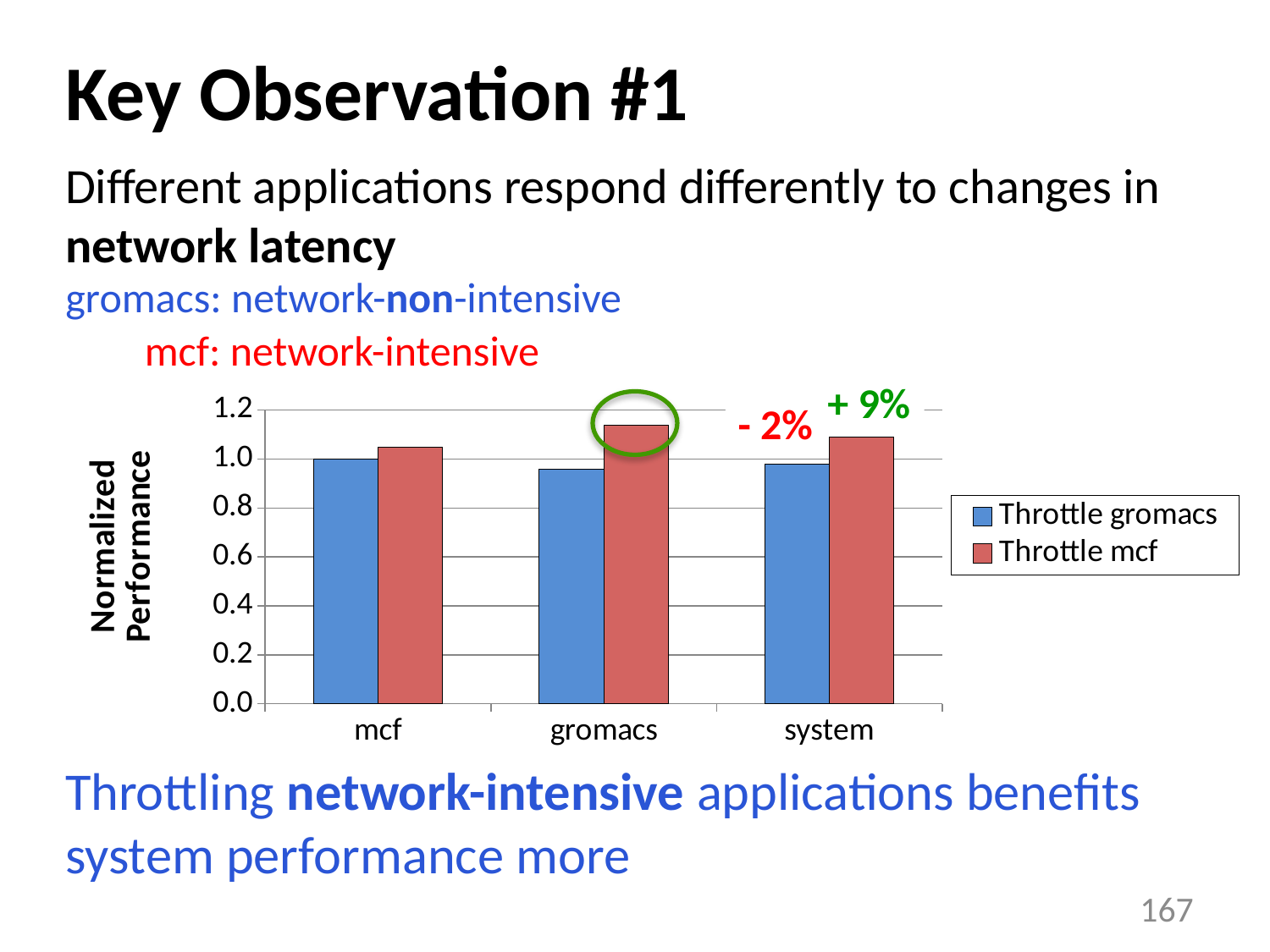
Is the Throttle mcf value for gromacs greater or less than 1.0? greater Is the Throttle mcf value for system greater or less than 1.0? greater How many categories are shown on the x axis of the chart? 3 Which category has the highest Throttle mcf value? gromacs What are the two series named in the chart's legend? Throttle gromacs and Throttle mcf What is the label on the chart's y axis? Normalized Performance What is the Throttle gromacs value for mcf? 1.0 How many series does the chart's legend list? 2 What percentage change is annotated above the Throttle mcf bar for system? + 9% For the gromacs category, which series has the larger value, Throttle gromacs or Throttle mcf? Throttle mcf Is the Throttle gromacs value for gromacs greater or less than 1.0? less What kind of chart is shown on the slide? bar chart